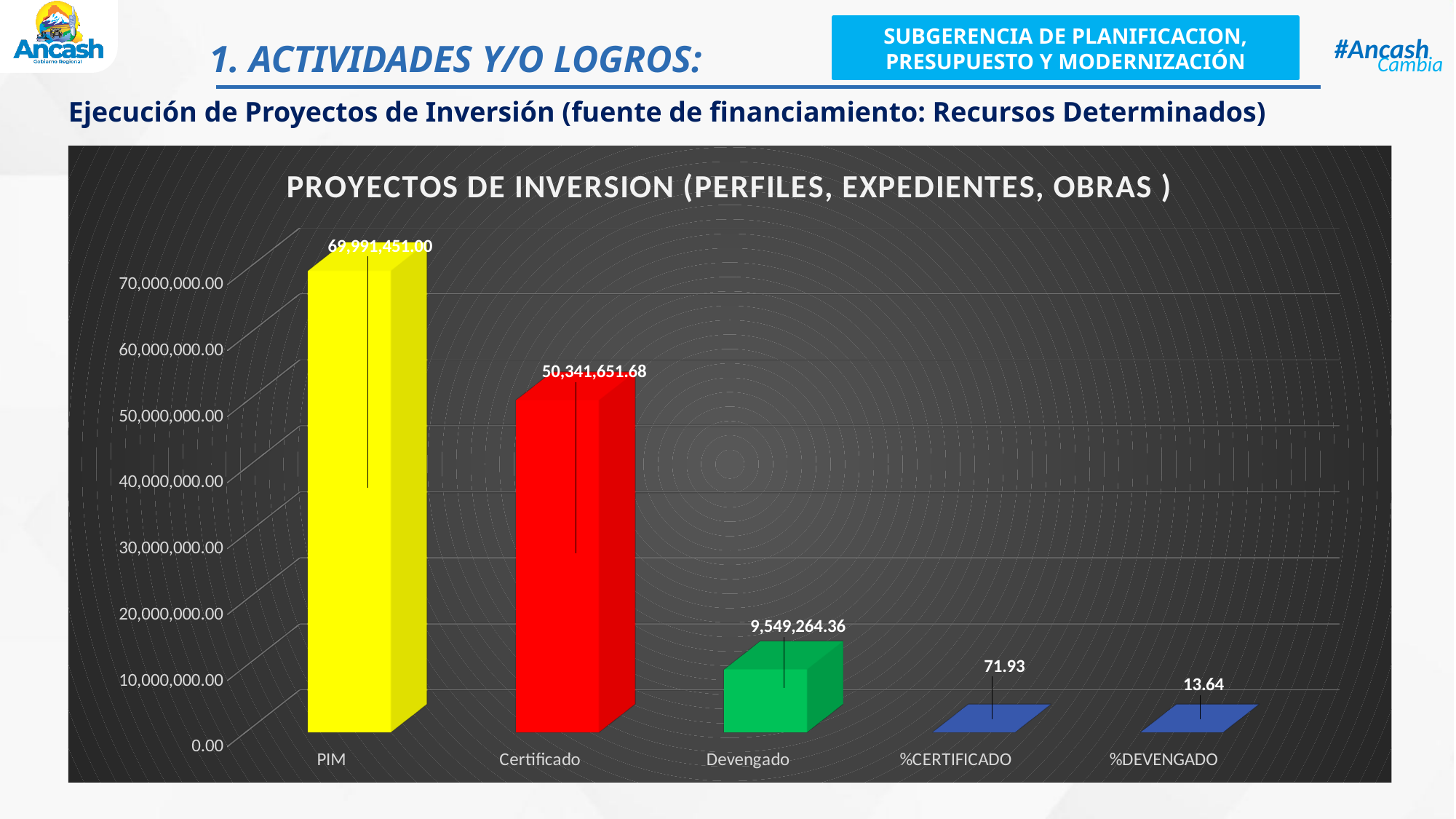
Which is larger, the Certificado value or the Devengado value? Certificado How many categories are shown on the x axis? 5 Is the value for PIM greater or less than 60,000,000.00? greater What is the value shown for Certificado? 50,341,651.68 What is the value shown for Devengado? 9,549,264.36 What is the title of the chart? PROYECTOS DE INVERSION (PERFILES, EXPEDIENTES, OBRAS ) What is the difference between the PIM value and the Certificado value? 19,649,799.32 What is the value shown for PIM? 69,991,451.00 Which category has the lowest value? %DEVENGADO What value is labelled on the %DEVENGADO bar? 13.64 Which category has the highest value? PIM What value is labelled on the %CERTIFICADO bar? 71.93